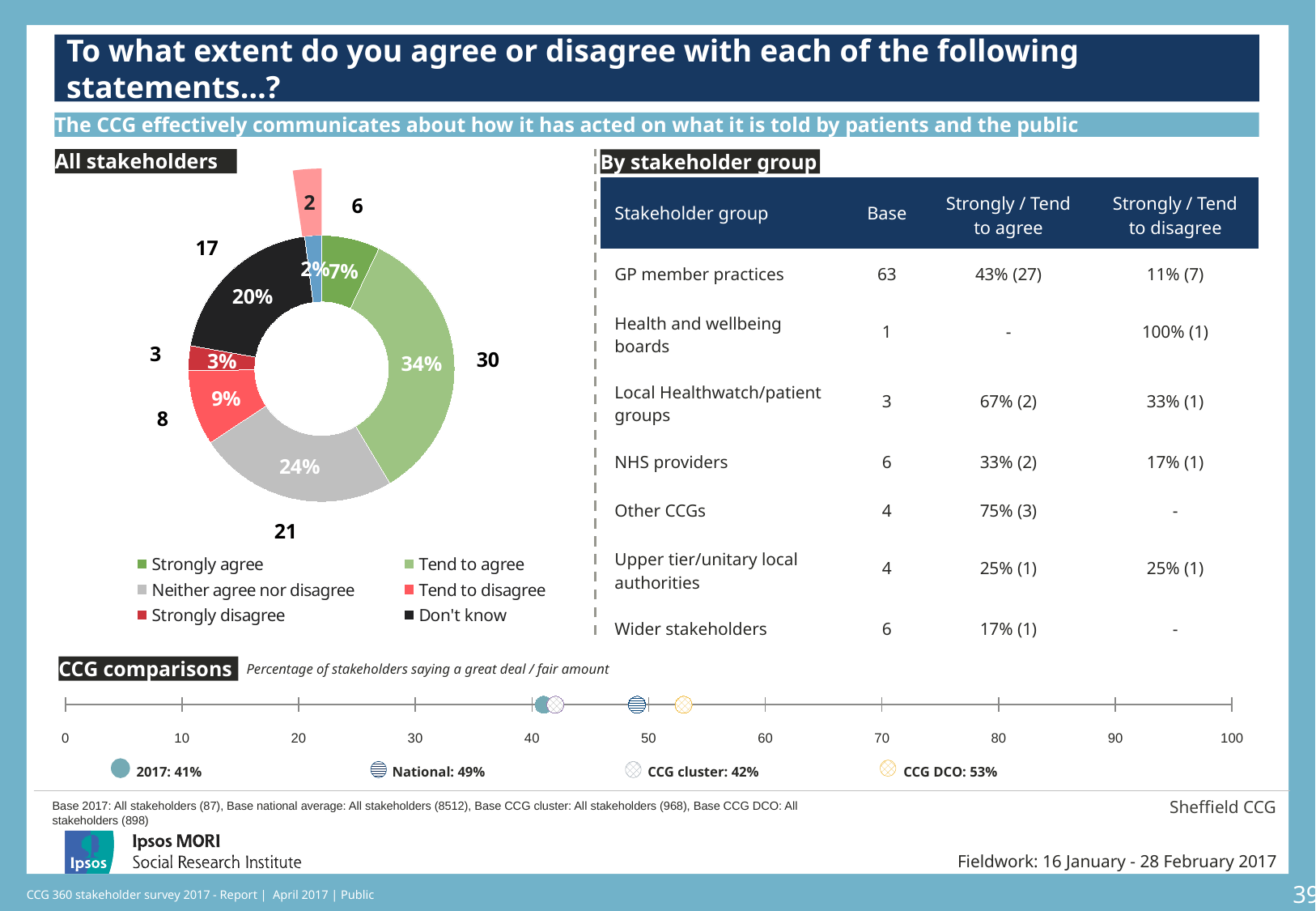
In the 'All stakeholders' donut chart, what is the difference in percentage points between 'Tend to agree' and 'Neither agree nor disagree'? 10 In the 'CCG comparisons' chart, what is the difference between the National value and the 2017 value? 8 percentage points In the 'All stakeholders' donut chart, what percentage of stakeholders strongly disagree? 3% What kind of chart is used in the 'All stakeholders' section? Donut chart In the 'All stakeholders' donut chart, what percentage of stakeholders tend to agree? 34% In the 'CCG comparisons' chart, what is the value for 2017? 41% In the 'All stakeholders' donut chart, which is larger: the share for 'Tend to disagree' or the share for 'Strongly agree'? Tend to disagree In the 'CCG comparisons' chart, what is the value for CCG DCO? 53% In the 'All stakeholders' donut chart, which response category has the largest share? Tend to agree In the 'All stakeholders' donut chart, what percentage of stakeholders answered 'Don't know'? 20% In the 'CCG comparisons' chart, which marker has the lowest value? 2017: 41% How many entries does the legend of the 'All stakeholders' donut chart list? 6